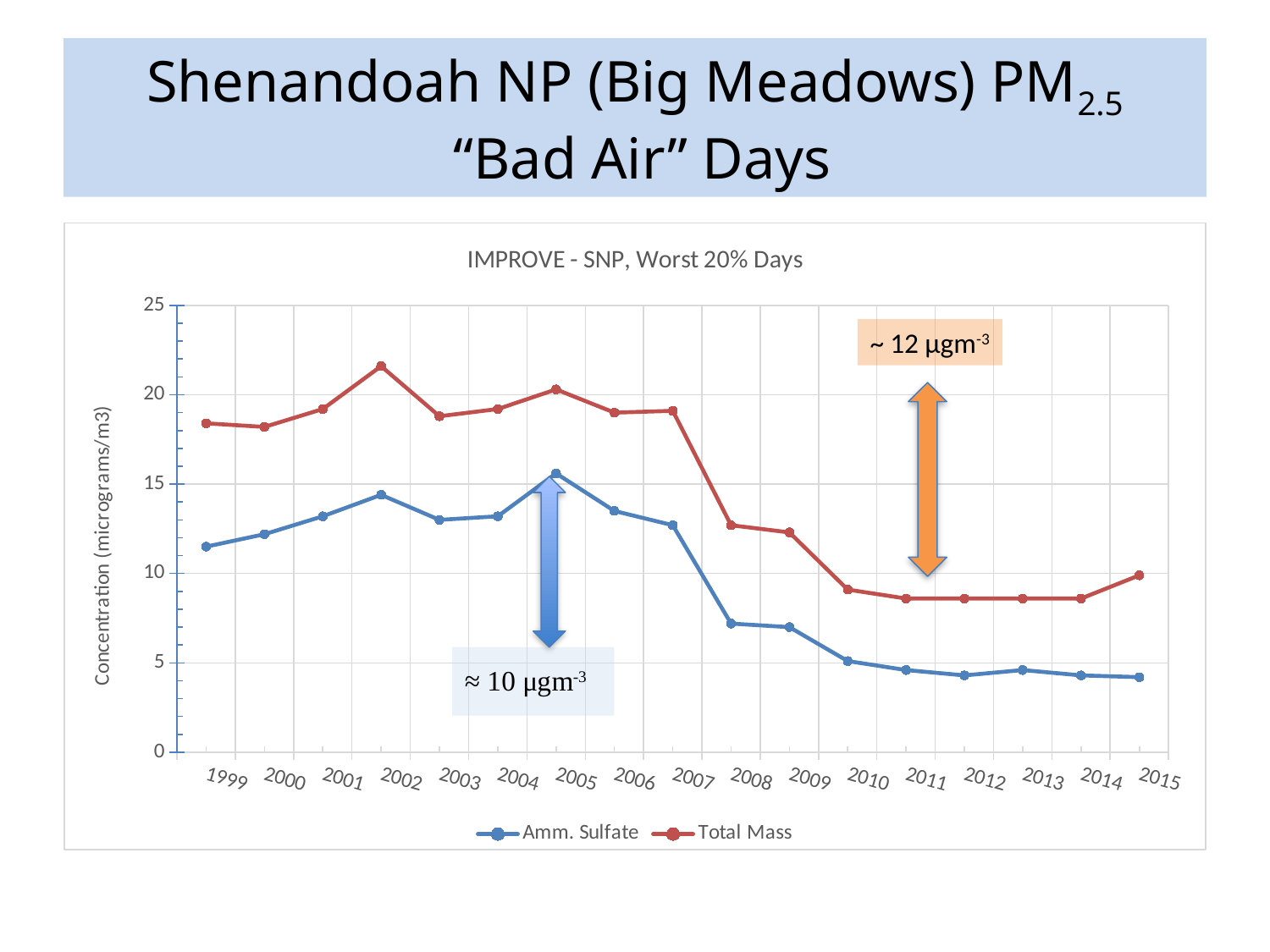
How many series does the legend list? 2 What is the title printed above the chart? IMPROVE - SNP, Worst 20% Days What kind of chart is shown on the slide? line chart Does the Amm. Sulfate series rise or fall between 2007 and 2010? fall Is the Total Mass value for 2010 greater or less than 10? less Which series has the larger value in 2005, Amm. Sulfate or Total Mass? Total Mass Is the Total Mass value for 2002 greater or less than 20? greater How many years are plotted along the x axis? 17 In which year is the Total Mass value highest? 2002 In which year is the Amm. Sulfate value highest? 2005 Is the Amm. Sulfate value for 2008 greater or less than 5? greater